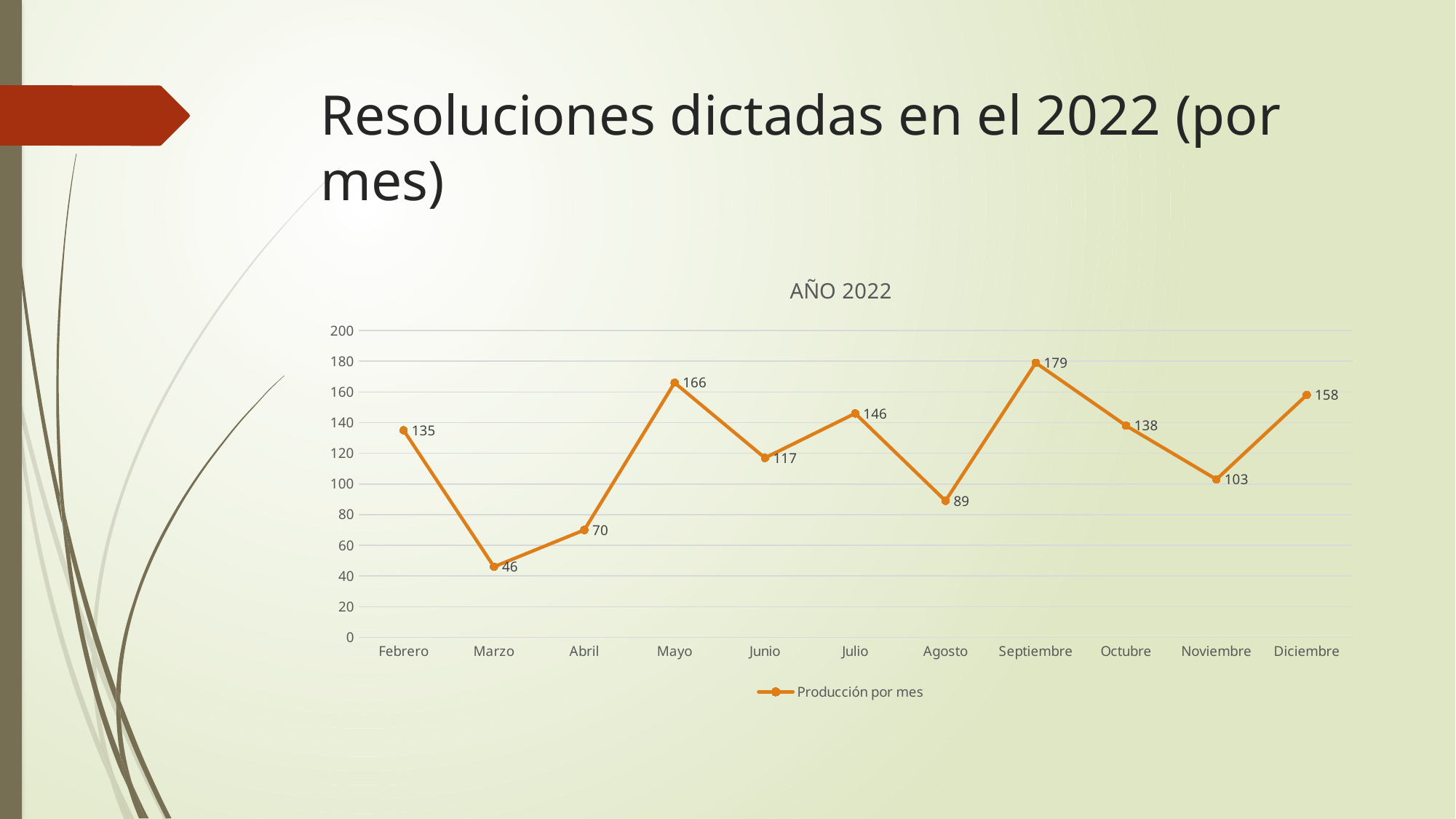
How many months are plotted on the chart? 11 What is the value for Mayo? 166 What is the title of the chart? AÑO 2022 Which month has the highest value? Septiembre Is the value for Diciembre greater or less than 140? greater What is the value for Febrero? 135 Which is larger, the value for Julio or the value for Octubre? Julio Which month has the lowest value? Marzo What kind of chart is shown? line chart How many series does the legend list? 1 What is the value for Noviembre? 103 What is the difference between the values for Septiembre and Agosto? 90